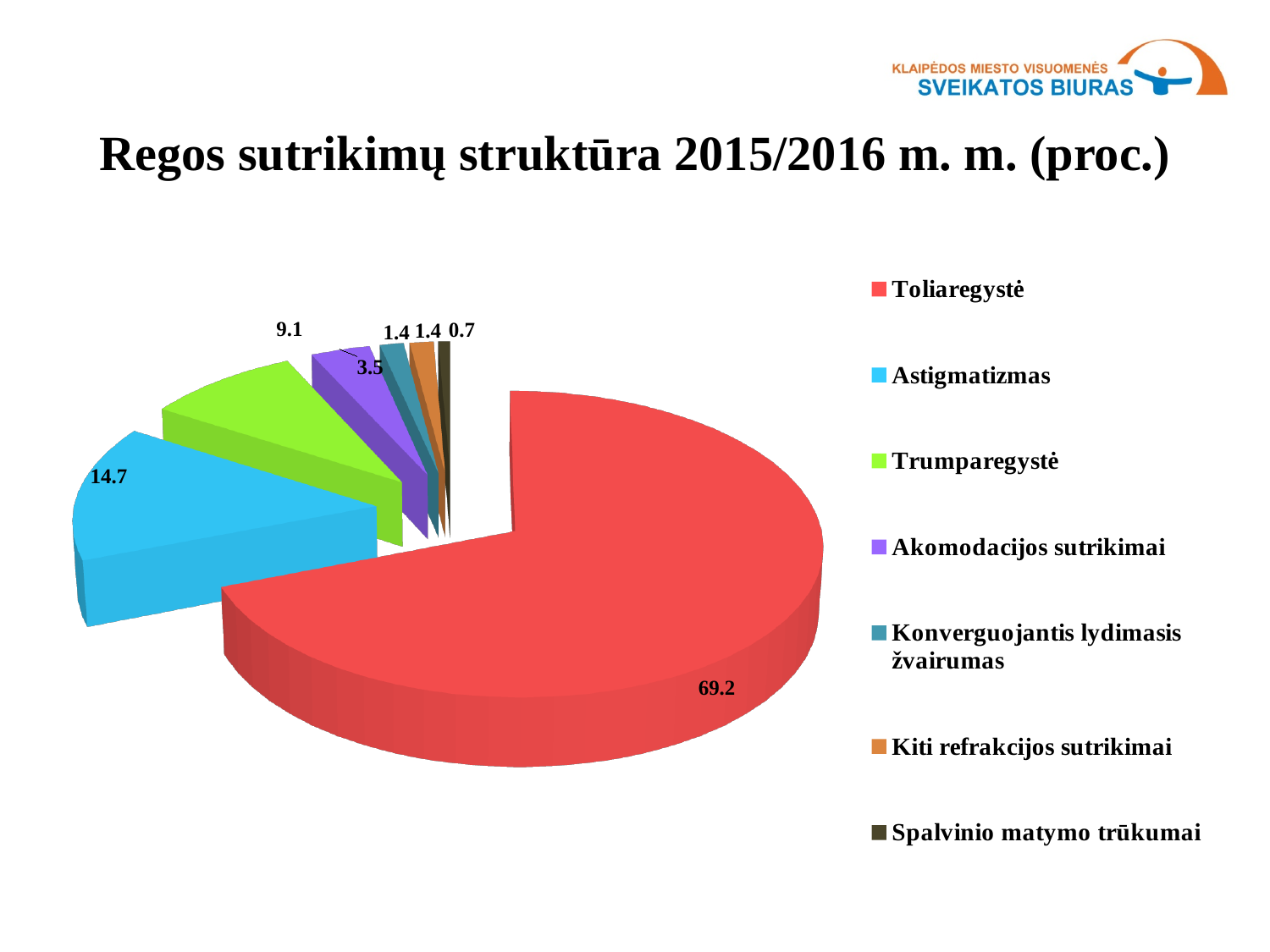
What is the value for Toliaregystė? 69.2 What is the value for Akomodacijos sutrikimai? 3.5 What is the title of the chart? Regos sutrikimų struktūra 2015/2016 m. m. (proc.) What is the value for Trumparegystė? 9.1 What is the difference between the values for Toliaregystė and Astigmatizmas? 54.5 Which is larger, the value for Trumparegystė or the value for Akomodacijos sutrikimai? Trumparegystė Which category has the largest slice of the pie? Toliaregystė What type of chart is shown on the slide? pie chart Which category has the smallest slice of the pie? Spalvinio matymo trūkumai How many categories does the legend list? 7 What is the value for Astigmatizmas? 14.7 What is the value for Spalvinio matymo trūkumai? 0.7